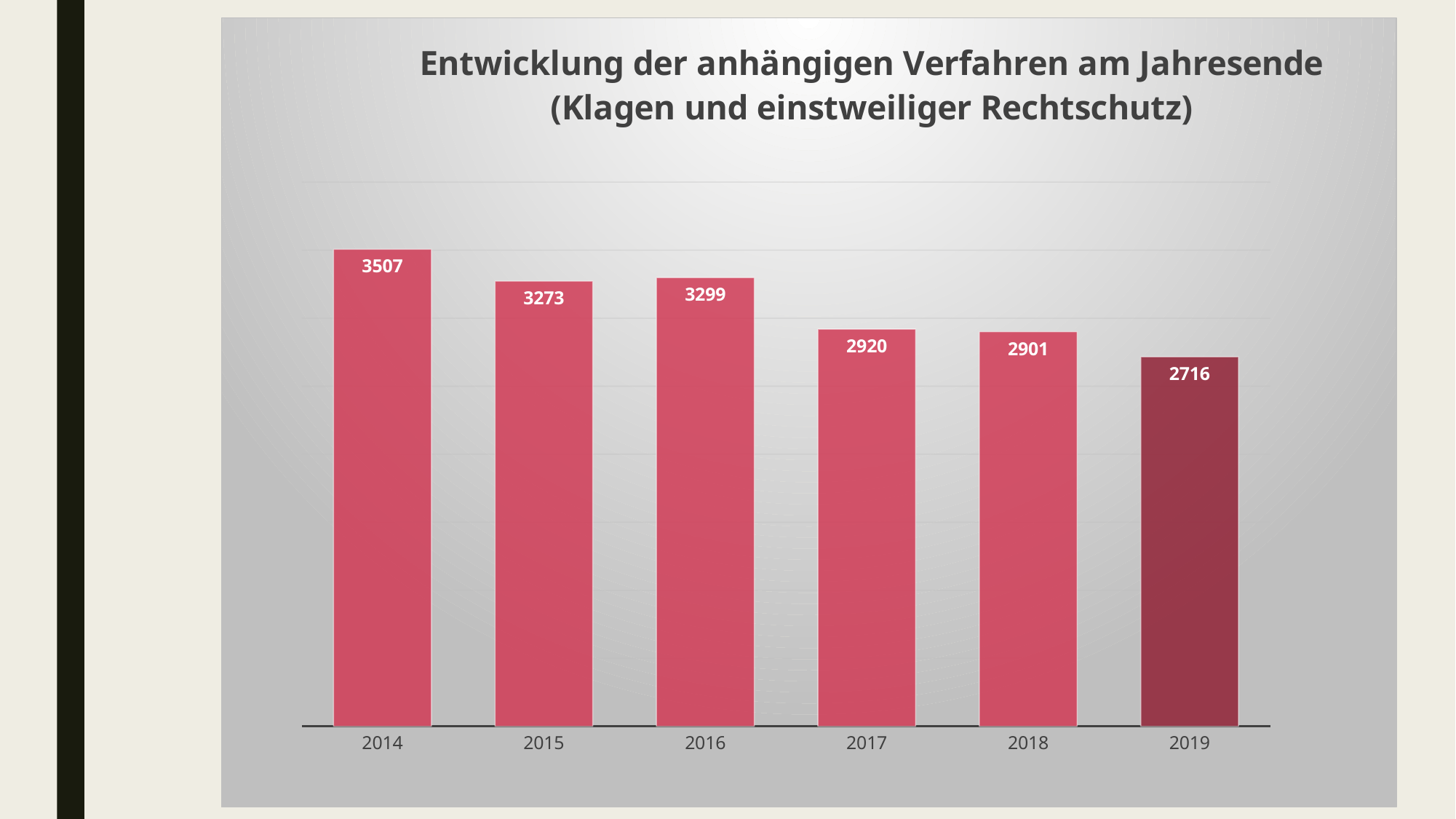
How many years are shown on the x axis? 6 What is the difference between the values for 2014 and 2019? 791 Do the values generally rise or fall from 2014 to 2019? fall Which year has the lowest value? 2019 What is the title of the chart? Entwicklung der anhängigen Verfahren am Jahresende (Klagen und einstweiliger Rechtschutz) What is the value for 2019? 2716 What kind of chart is this? bar chart Which year has the highest value? 2014 What is the value for 2014? 3507 Which is larger, the value for 2015 or the value for 2016? 2016 What is the value for 2017? 2920 What is the difference between the values for 2016 and 2015? 26